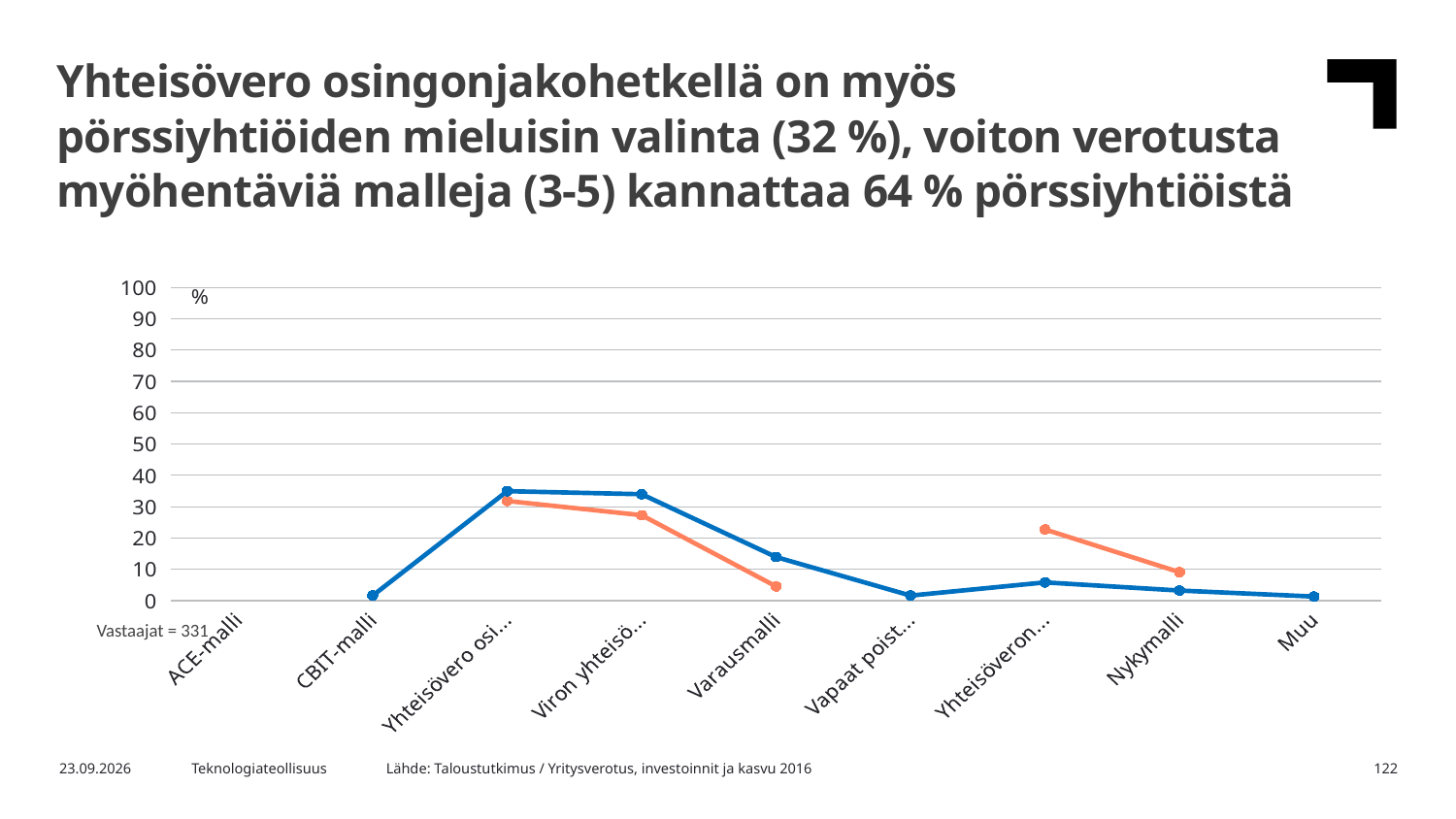
At 'Viron yhteisö...', which line has the larger value, the blue line or the orange line? the blue line How many lines (series) are plotted on the chart? 2 Is the value of the blue line for 'Nykymalli' greater or less than 10? less For the orange line, which category has the highest value? Yhteisövero osi... How many categories are shown on the x axis of the chart? 9 What unit is shown at the top of the y axis? % Is the value of the blue line for 'Varausmalli' greater or less than 20? less Is the value of the orange line for 'Varausmalli' greater or less than 10? less What kind of chart is shown on the slide? line chart Does the blue line rise or fall from 'Viron yhteisö...' to 'Vapaat poist...'? fall